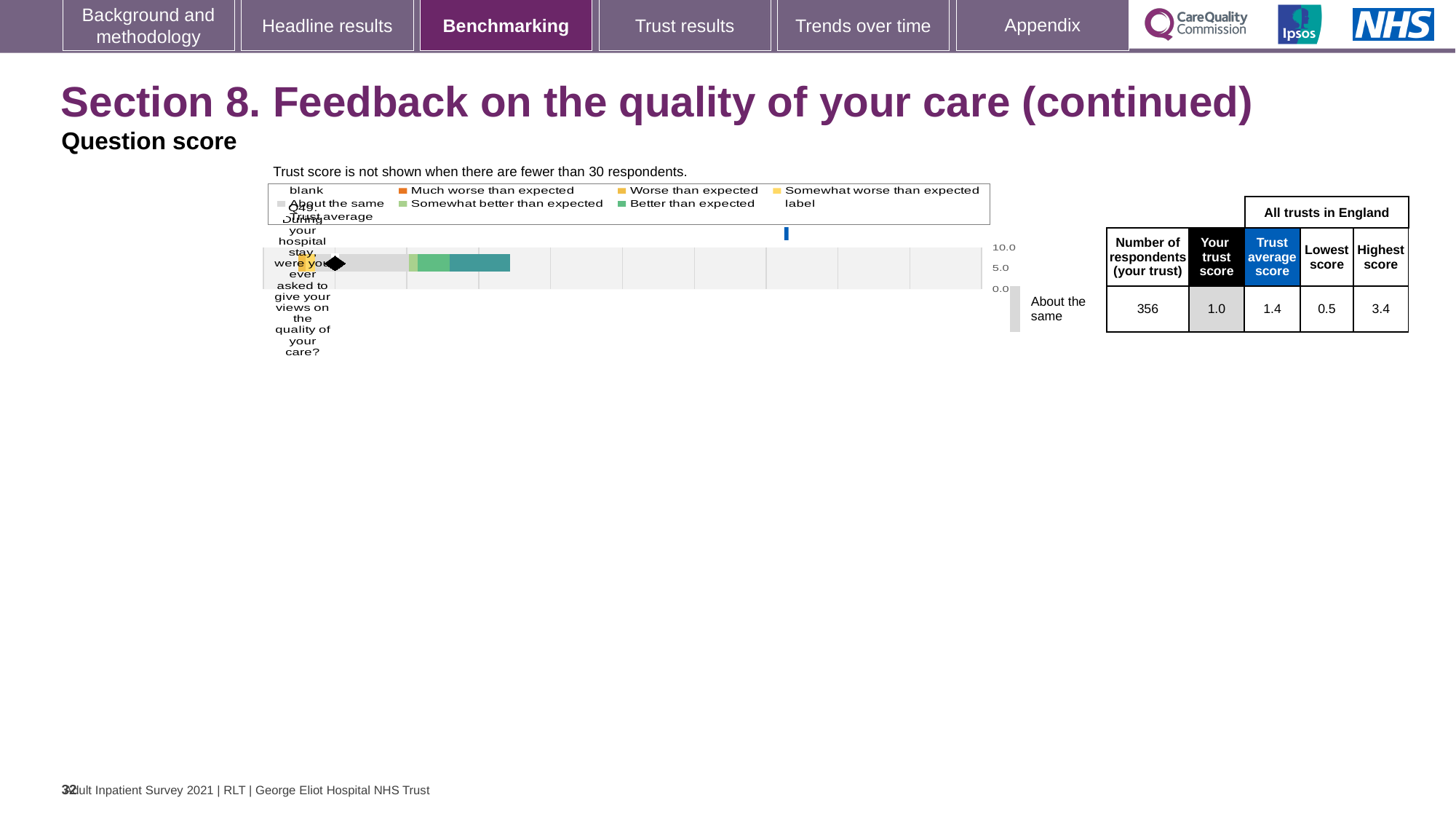
What is the difference between the highest score and the lowest score for Q49? 2.9 Is your trust score for Q49 higher or lower than the trust average score? lower How many respondents from your trust answered Q49? 356 What is the highest score among all trusts in England for Q49? 3.4 What kind of chart is used to show the Q49 benchmarking result? bar chart How many survey questions are plotted on the chart? 1 What is the lowest score among all trusts in England for Q49? 0.5 What is the 'Trust average score' for Q49 across all trusts in England? 1.4 Below how many respondents is the trust score not shown on the chart? 30 Which benchmark category is Q49 assigned to, as labelled beside the chart? About the same What is the 'Your trust score' value for Q49? 1.0